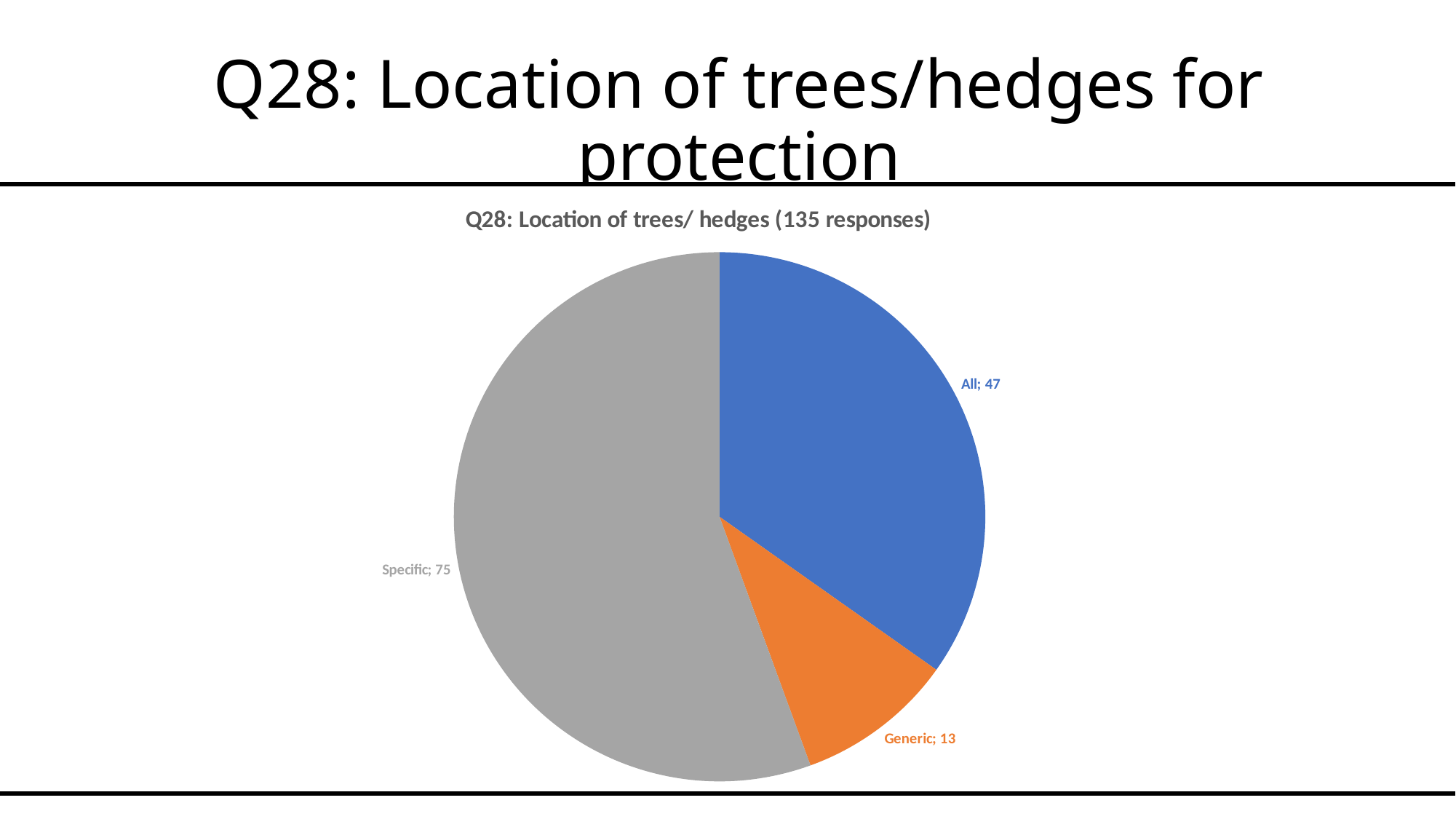
What is the value for the All slice? 47 What is the title of the chart? Q28: Location of trees/ hedges (135 responses) What is the total of all the slices in the pie chart? 135 What is the difference between the Specific and All values? 28 How many slices does the pie chart have? 3 What kind of chart is shown on the slide? pie chart What is the difference between the All and Generic values? 34 Which is larger, the value for All or the value for Generic? All What is the value for the Generic slice? 13 Which category has the smallest slice of the pie? Generic Which category has the largest slice of the pie? Specific What is the value for the Specific slice? 75